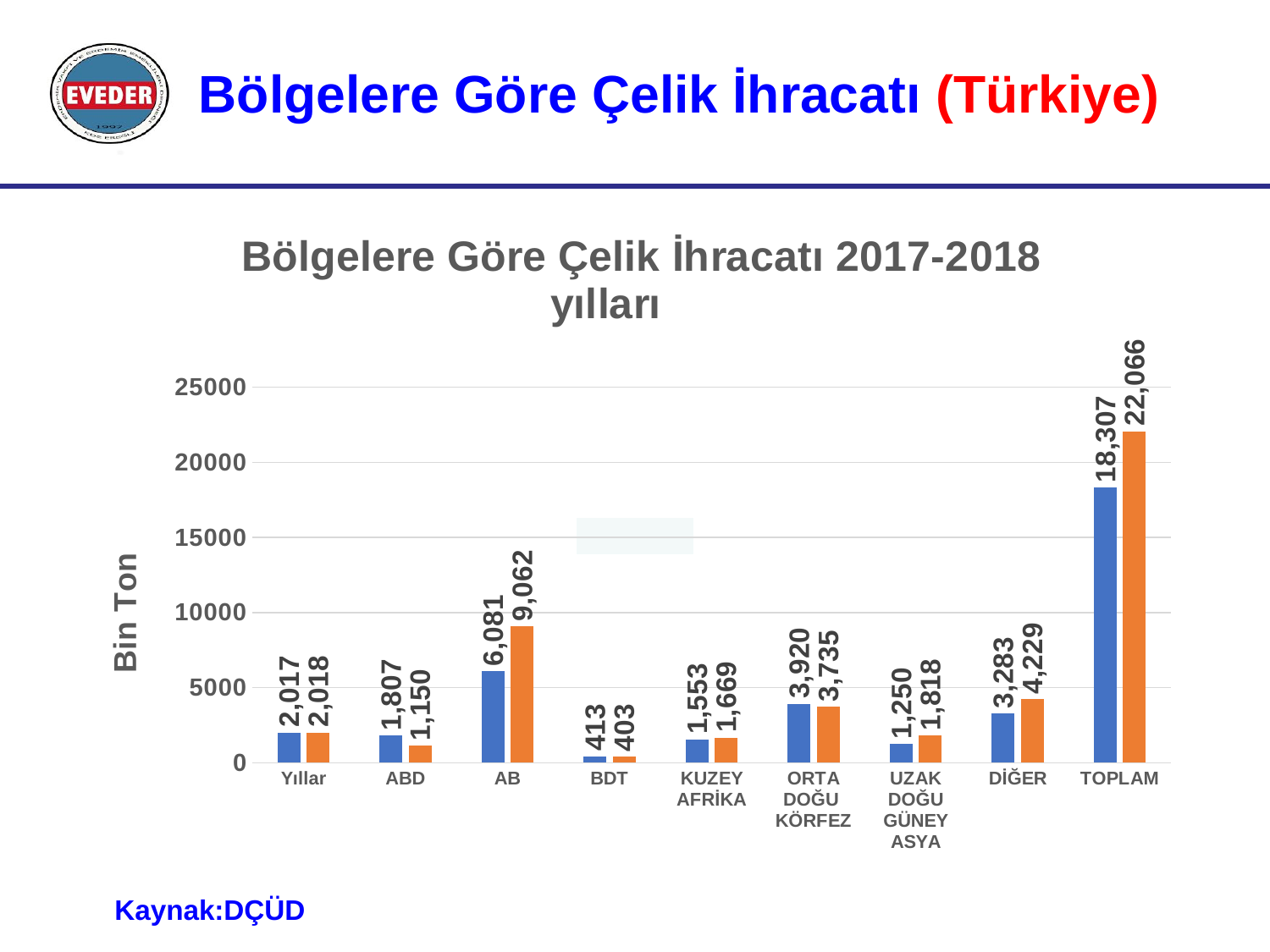
How many categories are shown on the x axis? 9 Excluding TOPLAM, which category has the highest orange bar? AB For ABD, which bar is larger, the blue or the orange? blue What is the value of the orange bar for TOPLAM? 22,066 What is the label of the vertical axis? Bin Ton Which category has the lowest blue bar? BDT What is the value of the orange bar for AB? 9,062 What is the difference between the orange and blue bars for TOPLAM? 3,759 What is the difference between the orange and blue bars for AB? 2,981 What is the value of the blue bar for ORTA DOĞU KÖRFEZ? 3,920 What is the value of the blue bar for BDT? 413 What type of chart is shown on the slide? bar chart